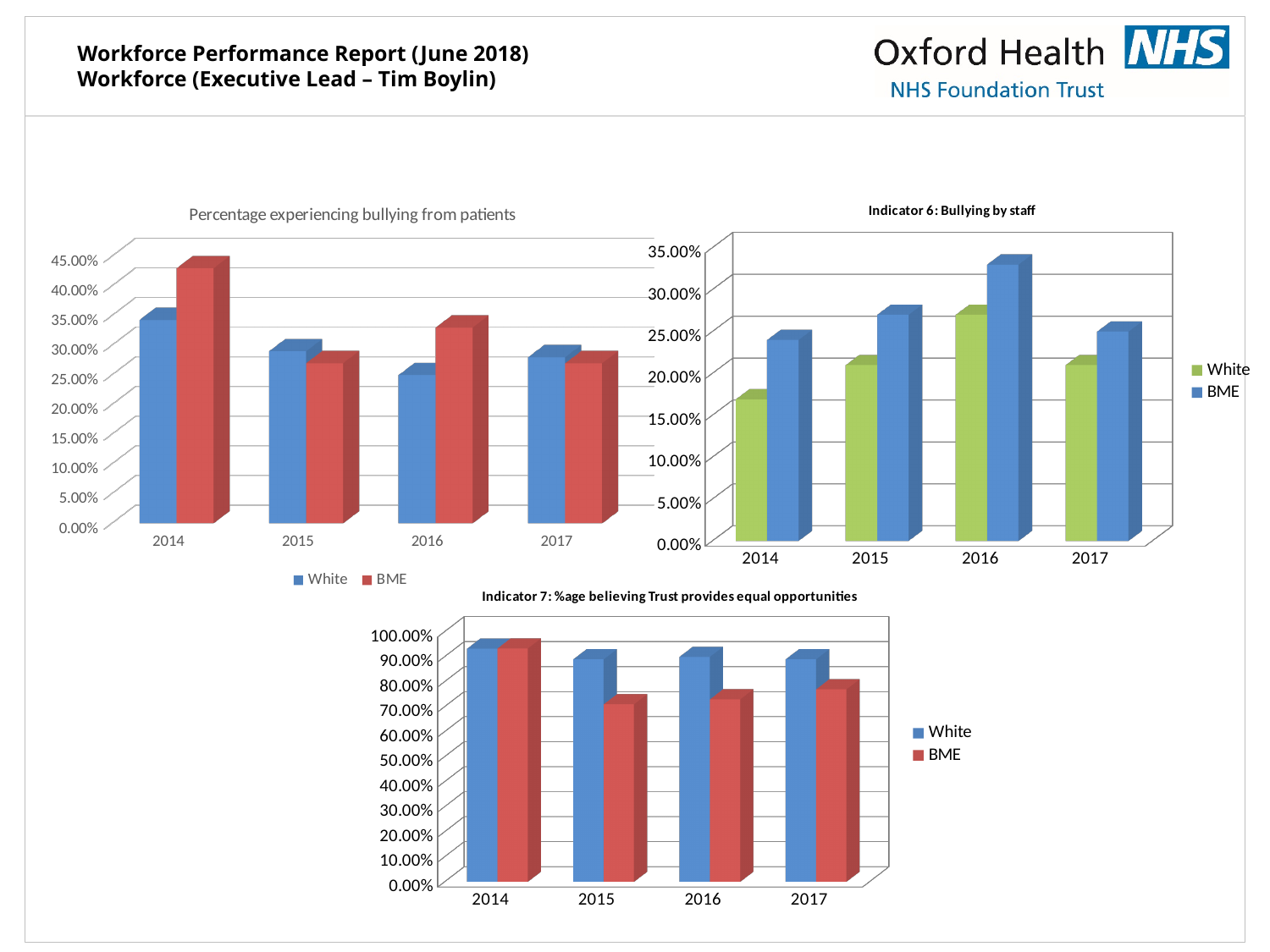
In the 'Percentage experiencing bullying from patients' chart, how many years are shown on the x axis? 4 In the 'Percentage experiencing bullying from patients' chart, is the BME value for 2014 greater or less than 40.00%? greater In the 'Indicator 6: Bullying by staff' chart, is the BME value for 2016 greater or less than 30.00%? greater In the 'Indicator 6: Bullying by staff' chart, which year has the lowest White value? 2014 In the 'Indicator 6: Bullying by staff' chart, which is larger in 2014, White or BME? BME In the 'Percentage experiencing bullying from patients' chart, is the White value for 2016 greater or less than 30.00%? less In the 'Indicator 6: Bullying by staff' chart, which year has the highest BME value? 2016 In the 'Indicator 6: Bullying by staff' chart, does the White value rise or fall from 2014 to 2016? rise In the 'Indicator 7: %age believing Trust provides equal opportunities' chart, which is larger in 2017, White or BME? White In the 'Percentage experiencing bullying from patients' chart, which year has the highest BME value? 2014 How many series does the legend of the 'Indicator 7: %age believing Trust provides equal opportunities' chart list? 2